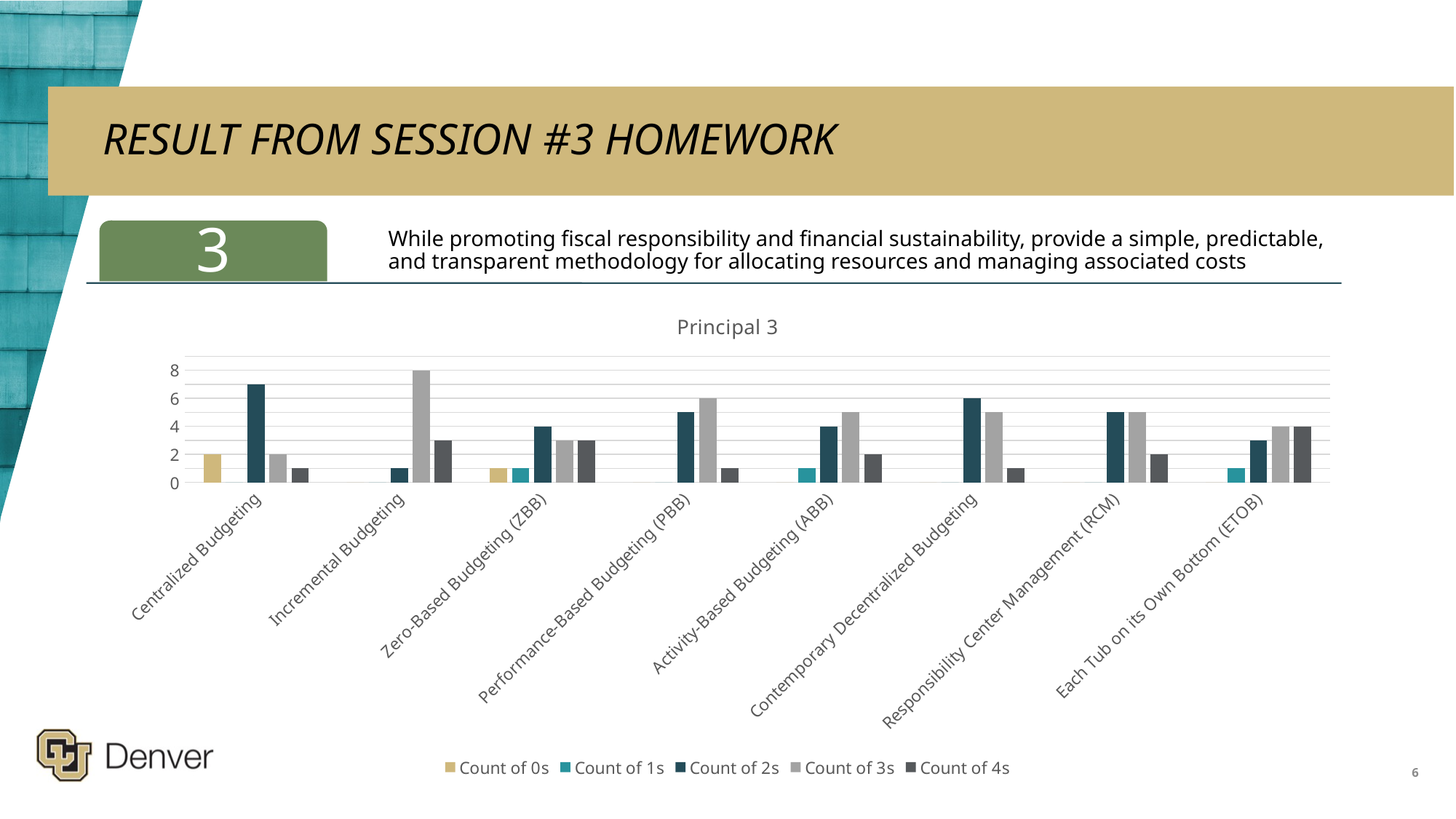
Is the Count of 2s for Centralized Budgeting greater or less than 6? greater How many series does the legend list? 5 What is the Count of 2s for Contemporary Decentralized Budgeting? 6 What is the title of the chart? Principal 3 What is the Count of 3s for Incremental Budgeting? 8 Which is larger: the Count of 2s for Centralized Budgeting or the Count of 2s for Incremental Budgeting? Centralized Budgeting What is the difference between the Count of 3s for Incremental Budgeting and the Count of 3s for Centralized Budgeting? 6 What is the Count of 3s for Performance-Based Budgeting (PBB)? 6 What kind of chart is shown on the slide? bar chart Which category has the highest Count of 3s? Incremental Budgeting How many budgeting categories are shown on the x axis? 8 What is the Count of 0s for Centralized Budgeting? 2